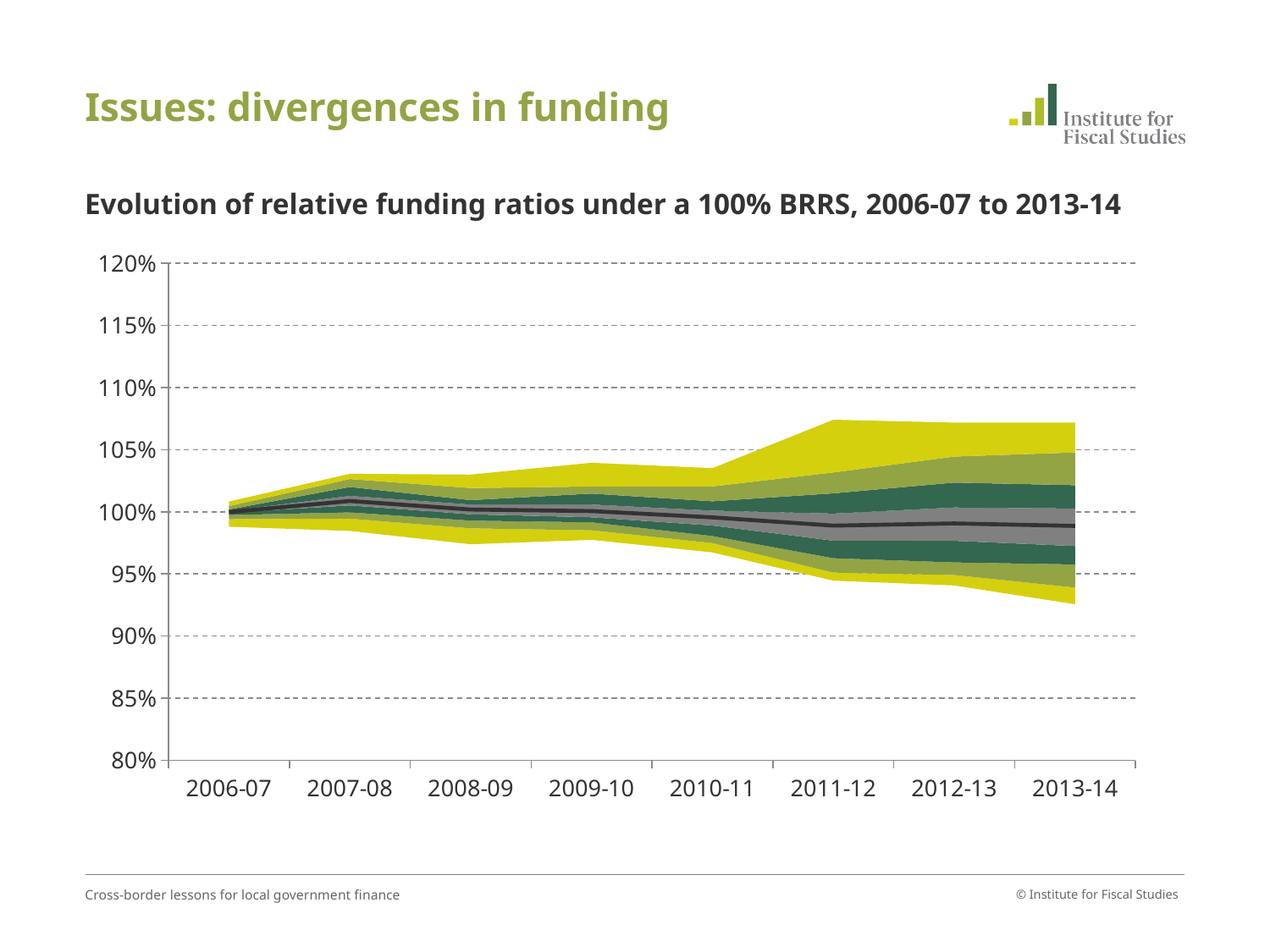
How many financial years are shown along the x axis? 8 Is the top of the outer band higher in 2013-14 or in 2006-07? 2013-14 What kind of chart is shown on the slide? Combination area and line chart (stacked area bands with a line) Is the top of the outermost (yellow) band in 2013-14 greater or less than 105%? greater Is the top of the outermost (yellow) band in 2006-07 greater or less than 105%? less What is the title of the chart? Evolution of relative funding ratios under a 100% BRRS, 2006-07 to 2013-14 What is the first financial year shown on the x axis? 2006-07 Does the spread between the top and bottom of the outer band widen or narrow from 2006-07 to 2013-14? widen Is the bottom of the outermost (yellow) band in 2013-14 greater or less than 95%? less Is the bottom of the outer band lower in 2013-14 or in 2008-09? 2013-14